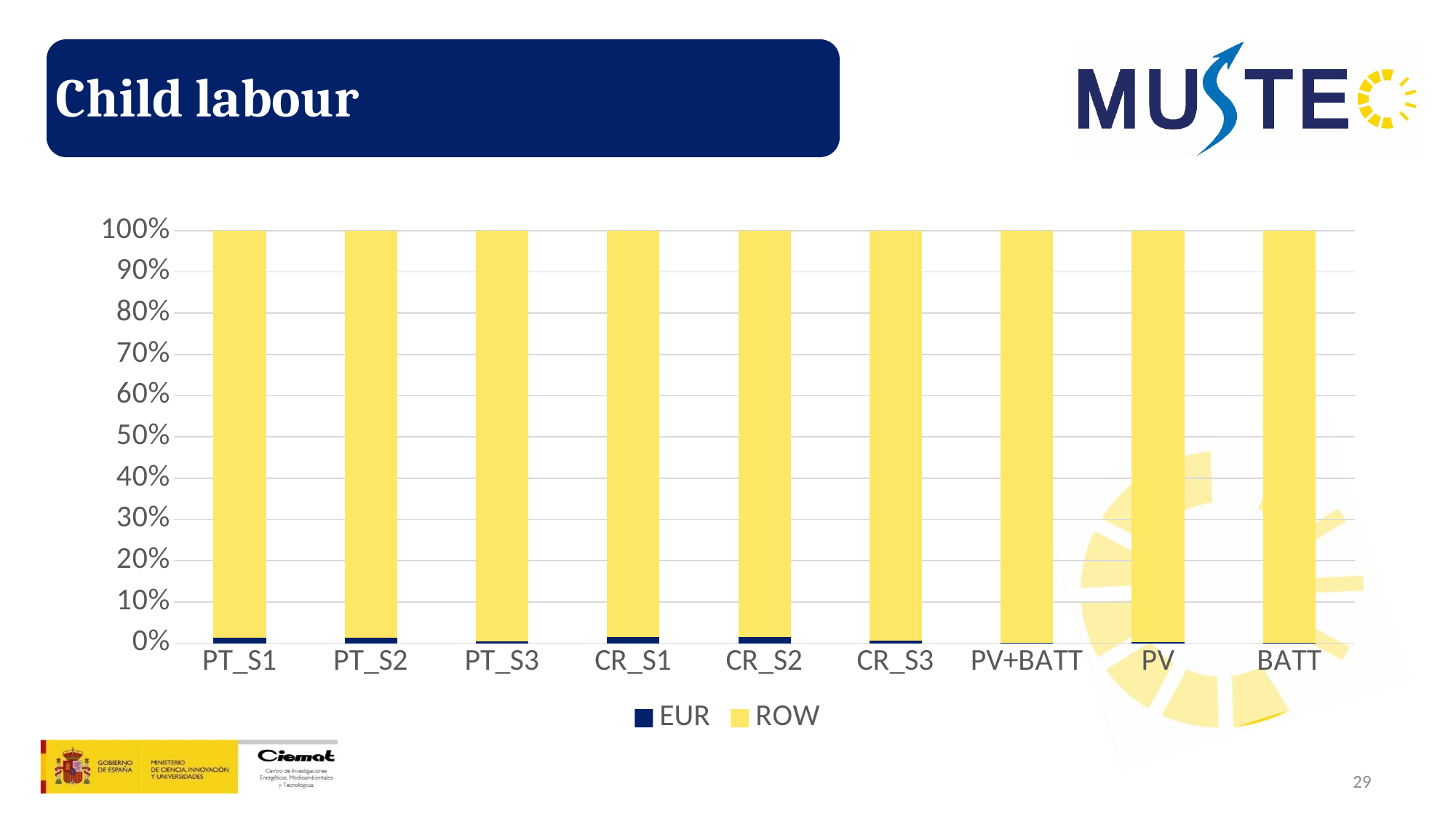
What is the total height of the stacked bar for PT_S1? 100% What kind of chart is shown on the slide? stacked bar chart What is the total height of the stacked bar for BATT? 100% Which category label appears first on the x axis? PT_S1 What is the title of the slide containing the chart? Child labour Is the ROW share for PV greater or less than 50%? greater How many categories are shown on the x axis of the chart? 9 How many series does the chart's legend list? 2 Is the ROW share for CR_S1 greater or less than 90%? greater Is the EUR share for PT_S2 greater or less than 10%? less What are the two series named in the legend? EUR and ROW For CR_S2, which series has the larger share, EUR or ROW? ROW